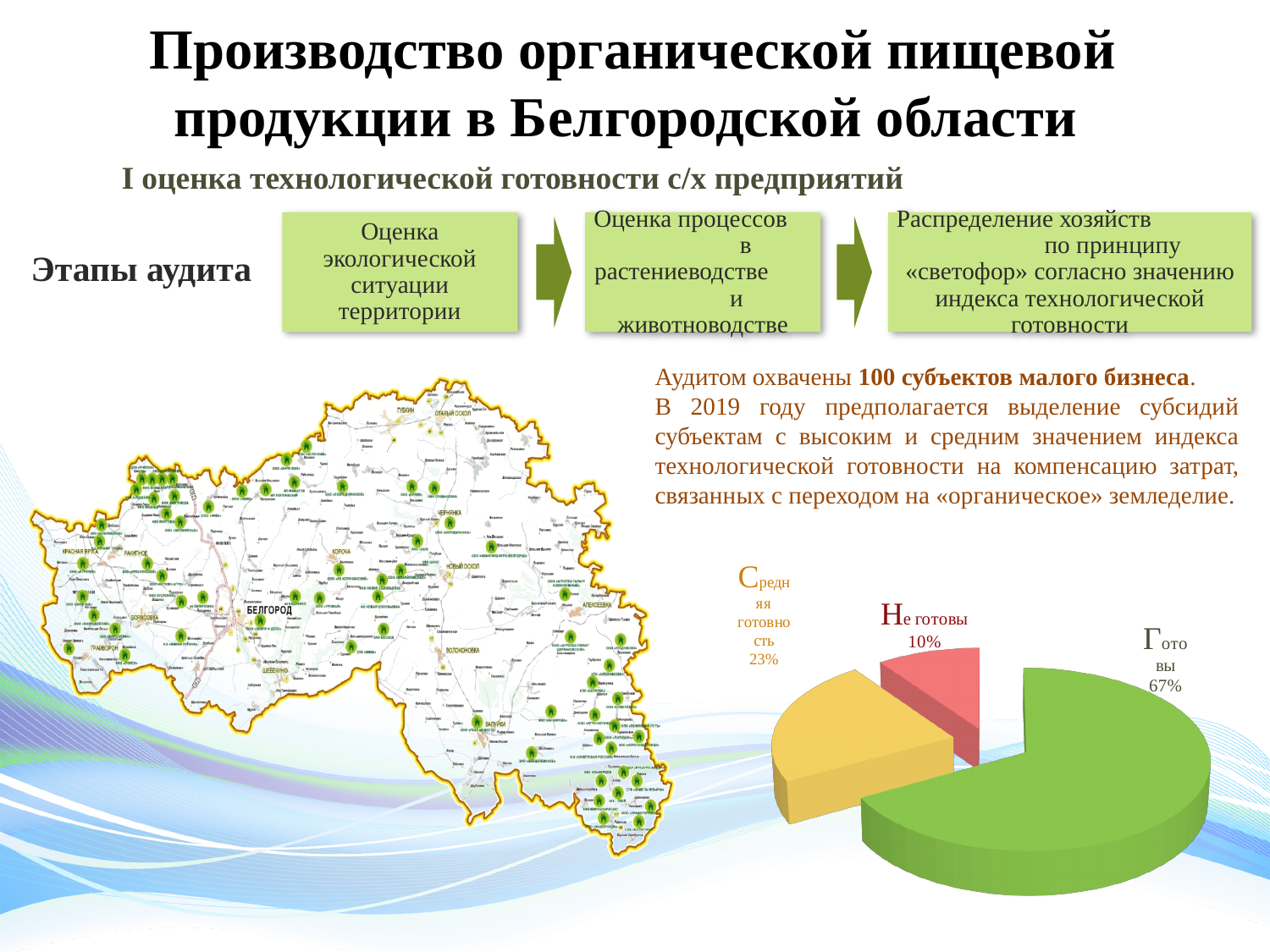
What is the difference in percentage points between the "Готовы" and "Не готовы" slices? 57 What kind of chart is shown on the slide? pie chart Which slice of the pie chart is the smallest? Не готовы What is the difference in percentage points between the "Средняя готовность" and "Не готовы" slices? 13 Which is larger, the "Средняя готовность" slice or the "Не готовы" slice? Средняя готовность What colour is the "Готовы" slice in the pie chart? green What colour is the "Не готовы" slice in the pie chart? red What share of the pie does the "Не готовы" slice represent? 10% What share of the pie does the "Готовы" slice represent? 67% How many slices does the pie chart have? 3 Which slice of the pie chart is the largest? Готовы What share of the pie does the "Средняя готовность" slice represent? 23%